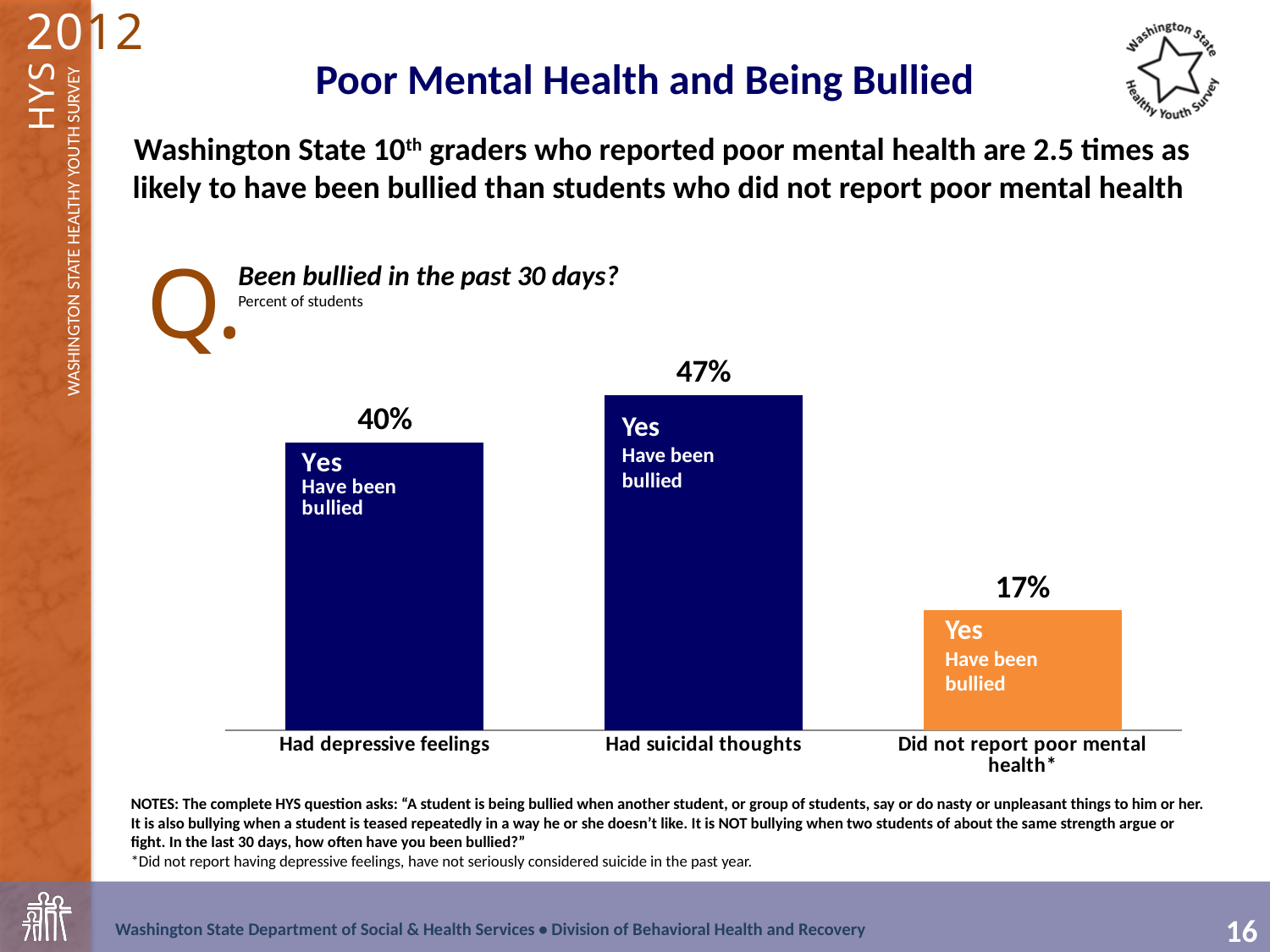
What percentage of students who had depressive feelings reported having been bullied in the past 30 days? 40% What is the difference in percentage points between students who had suicidal thoughts and students who did not report poor mental health? 30 Which is larger: the percentage for students who had depressive feelings or for students who did not report poor mental health? Had depressive feelings What question does the chart report responses to? Been bullied in the past 30 days? What percentage of students who had suicidal thoughts reported having been bullied? 47% Which category has the lowest percentage of students who have been bullied? Did not report poor mental health* Which category has the highest percentage of students who have been bullied? Had suicidal thoughts What percentage of students who did not report poor mental health reported having been bullied? 17% How many categories are shown on the chart? 3 Which bar is shown in orange rather than dark blue? Did not report poor mental health* What kind of chart is shown on the slide? Bar chart What is the difference in percentage points between students who had suicidal thoughts and students who had depressive feelings? 7